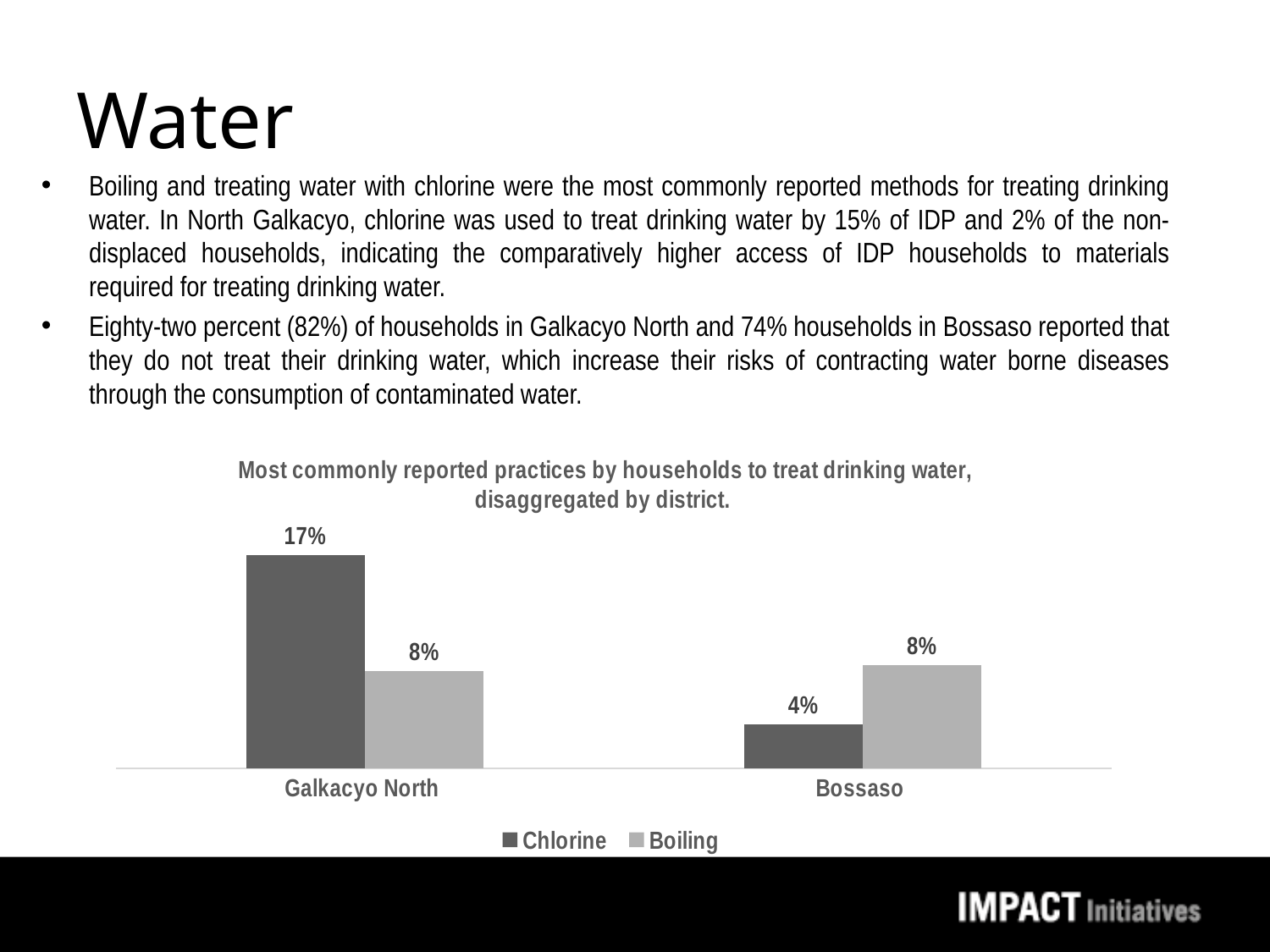
What percentage of households in Bossaso reported boiling their drinking water? 8% What is the value for Chlorine in Bossaso? 4% What percentage of households in Galkacyo North reported using chlorine to treat drinking water? 17% How many districts are shown on the x axis of the chart? 2 In Bossaso, which is larger: Chlorine or Boiling? Boiling Which district has the lowest value for Chlorine? Bossaso In Galkacyo North, what is the difference between the Chlorine and Boiling values? 9% What is the difference between the Chlorine values for Galkacyo North and Bossaso? 13% Which district has the highest value for Chlorine? Galkacyo North How many series does the chart legend list? 2 What is the value for Boiling in Galkacyo North? 8% What type of chart is shown on the slide? Bar chart